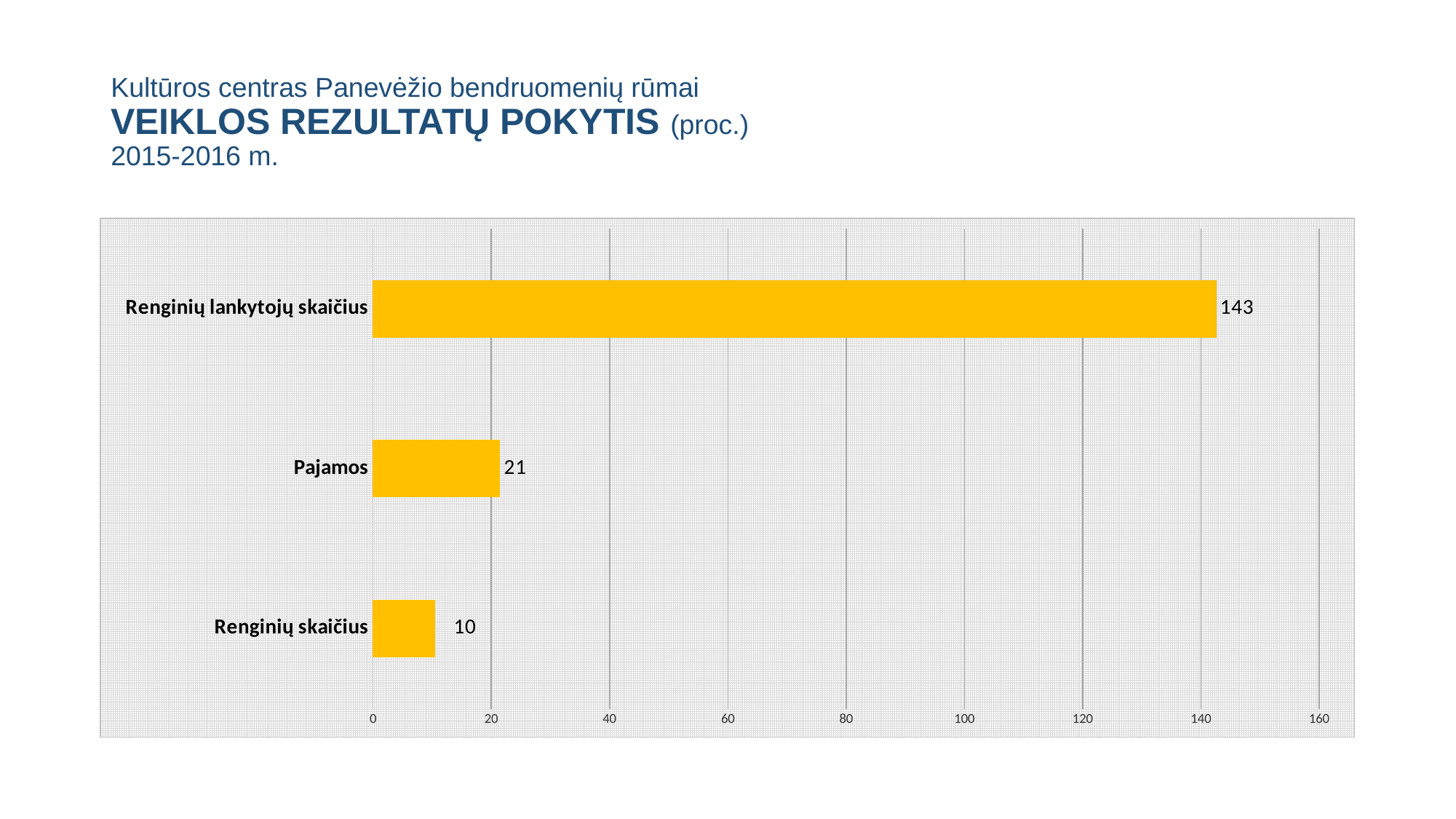
How many categories are shown in the chart? 3 What is the difference between the values for Renginių lankytojų skaičius and Pajamos? 122 Is the value for Renginių lankytojų skaičius greater or less than 140? greater What is the difference between the values for Pajamos and Renginių skaičius? 11 What is the value for Renginių skaičius? 10 Which category has the lowest value? Renginių skaičius What kind of chart is shown on the slide? bar chart What is the value for Renginių lankytojų skaičius? 143 Which is larger, the value for Pajamos or the value for Renginių skaičius? Pajamos Which category has the highest value? Renginių lankytojų skaičius What is the value for Pajamos? 21 What is the highest value shown on the horizontal axis? 160